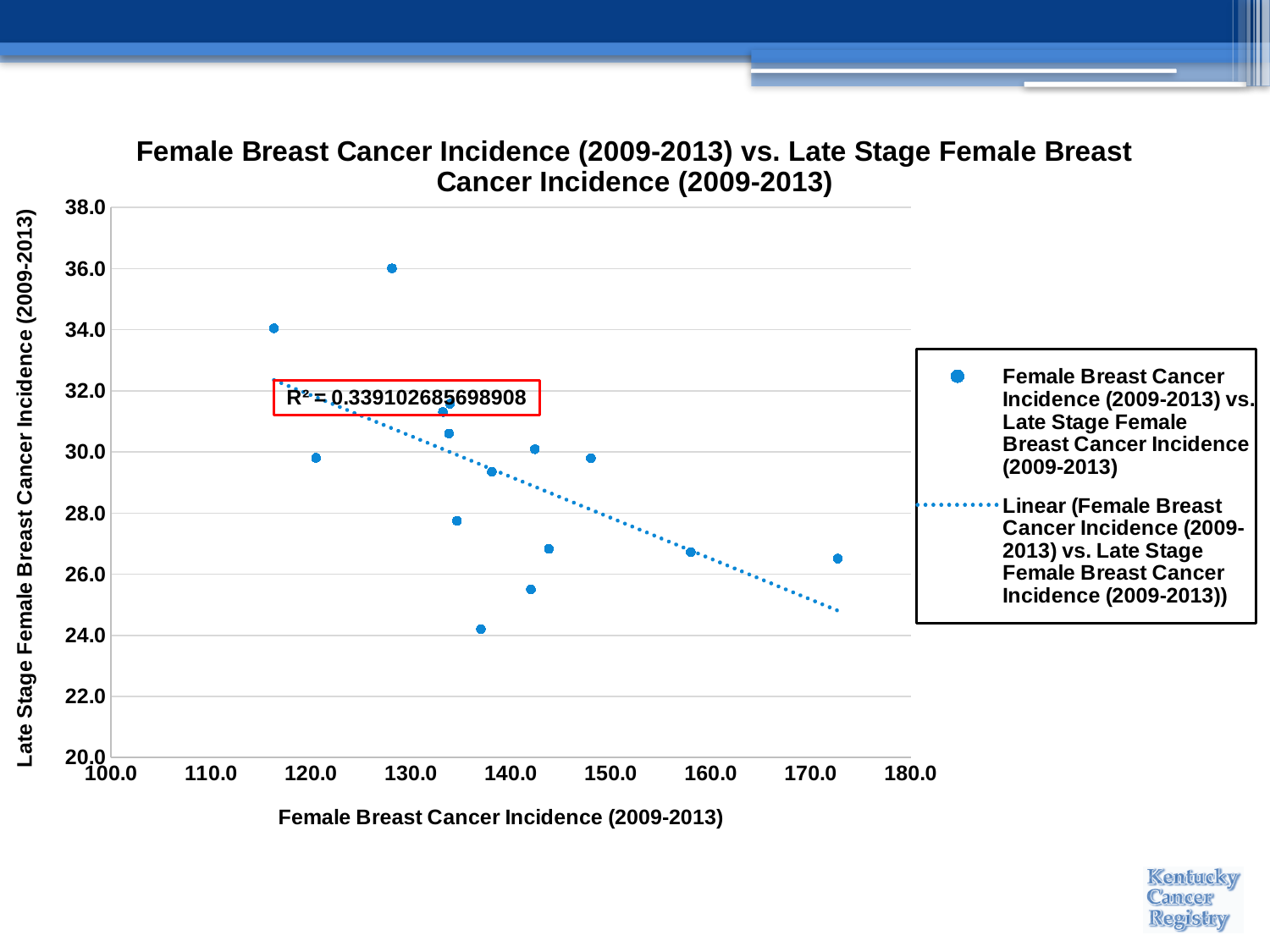
Does the linear trendline rise or fall as Female Breast Cancer Incidence increases along the x axis? Fall What is the minimum value shown on the x axis? 100.0 Is the late stage incidence value for the point with the highest late stage incidence greater or less than 34.0? greater How many entries does the legend list? 2 What R² value is printed on the chart? R² = 0.339102685698908 What kind of chart is shown on the slide? Scatter chart What is the title of the chart? Female Breast Cancer Incidence (2009-2013) vs. Late Stage Female Breast Cancer Incidence (2009-2013) Is the late stage incidence value for the point farthest to the right (around 173 on the x axis) greater or less than 28.0? less Which has the higher late stage incidence: the point near 128 on the x axis or the point near 158 on the x axis? The point near 128 Is the late stage incidence value for the lowest point on the chart greater or less than 26.0? less What is the maximum value shown on the y axis? 38.0 What is the label of the y axis? Late Stage Female Breast Cancer Incidence (2009-2013)